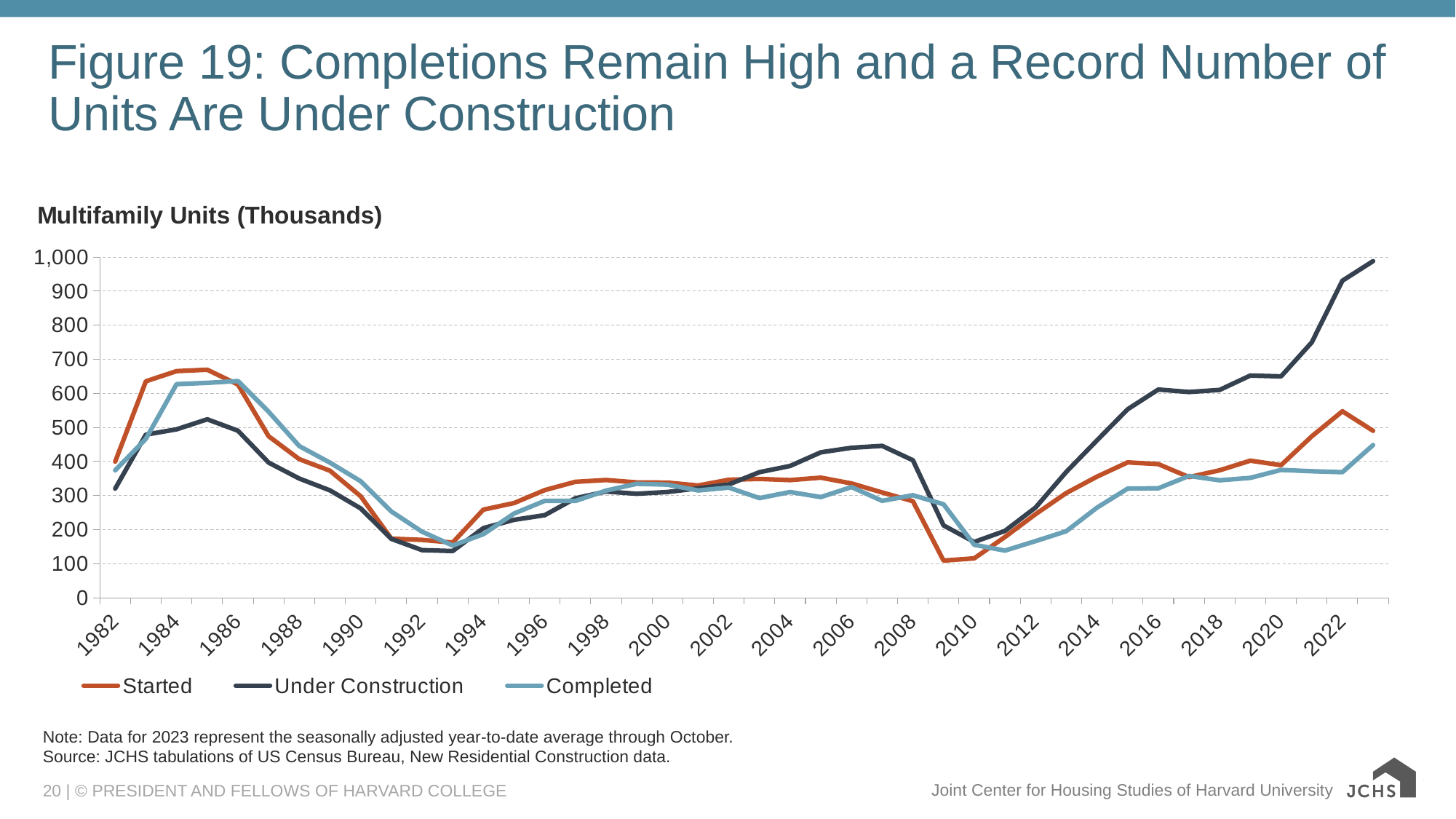
Does the Started line rise or fall between 1985 and 1992? fall At the far right end of the chart (2023), which series is higher: Under Construction or Started? Under Construction What are the names of the series in the legend? Started, Under Construction, Completed How many series does the legend list? 3 In 1984, which series is higher: Started or Under Construction? Started Is the value for Under Construction in 1992 greater or less than 200? less What is the label above the y axis of the chart? Multifamily Units (Thousands) Is the value for Under Construction at the far right end of the chart (2023) greater or less than 900? greater Is the value for Started in 2009 greater or less than 200? less What kind of chart is shown on the slide? line chart Does the Under Construction line rise or fall between 2010 and 2023? rise